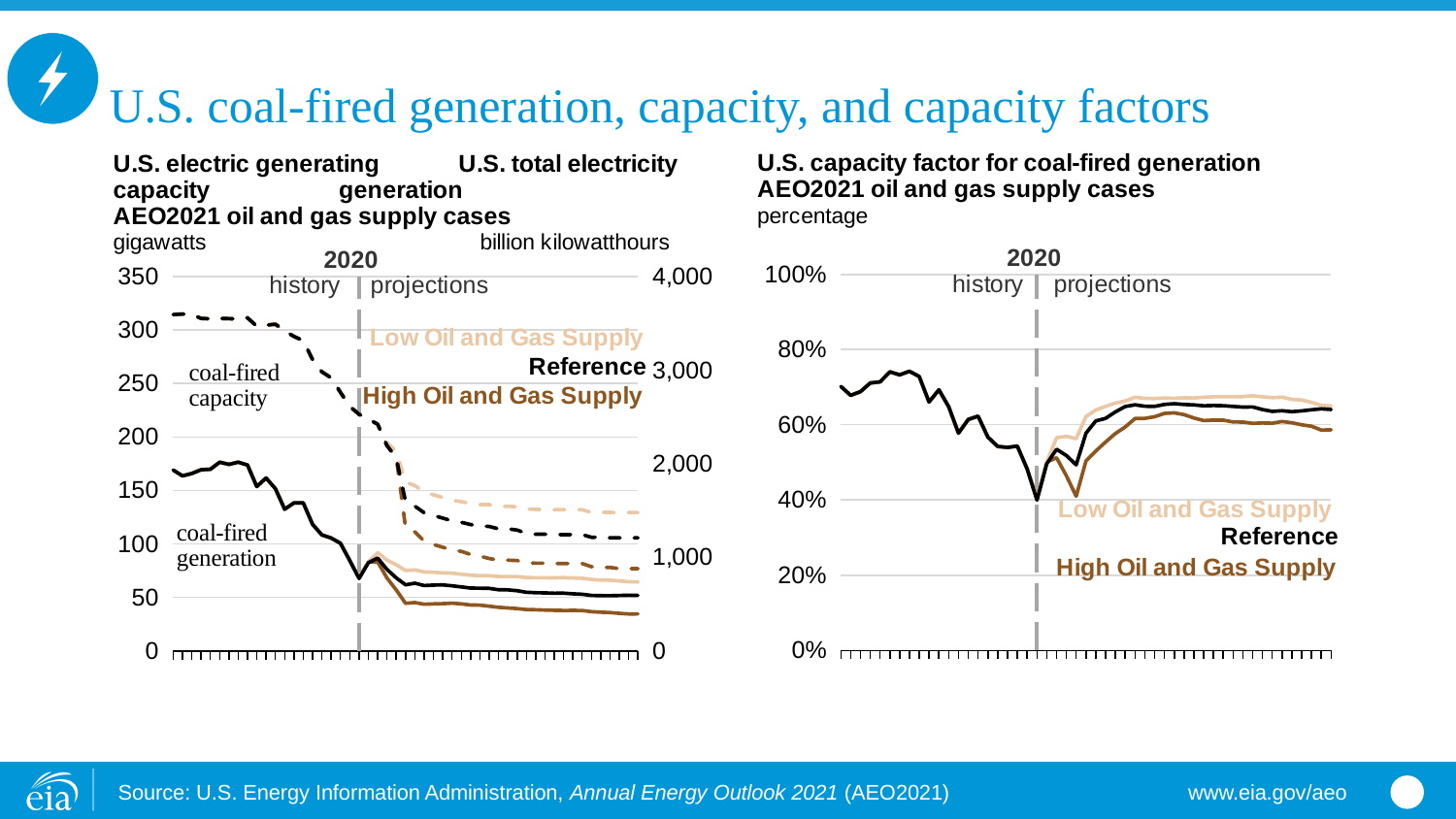
In the U.S. capacity factor for coal-fired generation chart, is the Low Oil and Gas Supply capacity factor at the end of the projection period greater or less than 60%? greater What kind of chart is the U.S. capacity factor for coal-fired generation chart? line chart In the left chart, what unit is shown on the left axis for coal-fired capacity? gigawatts In the U.S. capacity factor for coal-fired generation chart, which year separates history from projections? 2020 In the left chart, is the coal-fired capacity at the start of the history period greater or less than 300 gigawatts? greater In the left chart, is the coal-fired capacity in the Low Oil and Gas Supply case at the end of the projection period greater or less than 100 gigawatts? greater In the U.S. capacity factor for coal-fired generation chart, how many oil and gas supply cases are labelled? 3 In the left chart, does coal-fired capacity rise or fall from the start of the history period to the end of the projection period? fall In the U.S. capacity factor for coal-fired generation chart, at the end of the projection period, which case has the higher capacity factor: Low Oil and Gas Supply or High Oil and Gas Supply? Low Oil and Gas Supply How many charts are shown on the slide? 2 In the left chart, at the end of the projection period, which case has the higher coal-fired capacity: Low Oil and Gas Supply or High Oil and Gas Supply? Low Oil and Gas Supply